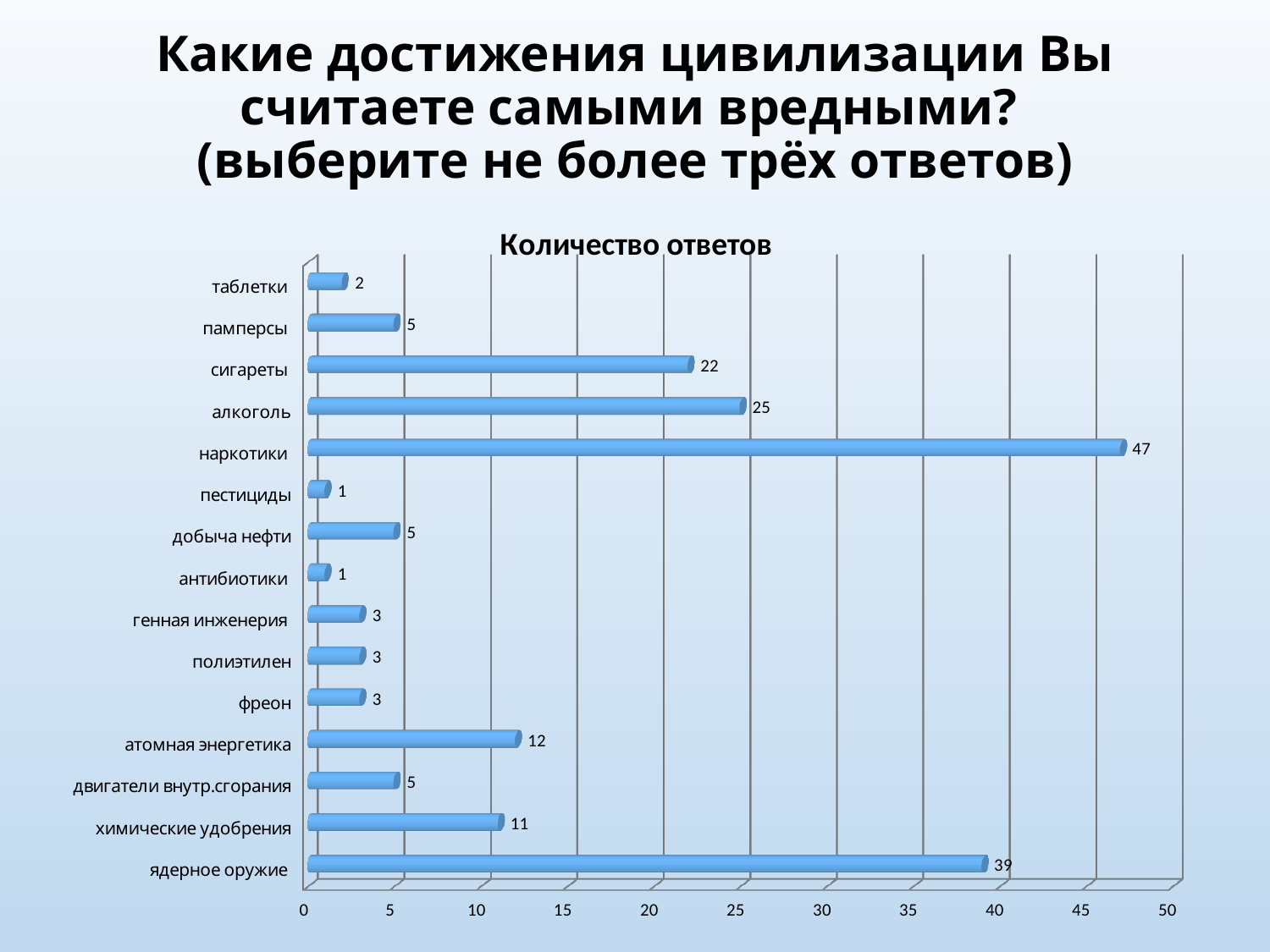
What is the difference between the values for алкоголь and сигареты? 3 Is the value for ядерное оружие greater or less than 35? greater What is the value for атомная энергетика? 12 What is the title of the chart? Количество ответов What is the difference between the values for наркотики and ядерное оружие? 8 What kind of chart is shown on the slide? bar chart What is the value for наркотики? 47 What is the value for ядерное оружие? 39 Which is larger, the value for химические удобрения or the value for атомная энергетика? атомная энергетика Which category has the highest value? наркотики What is the value for сигареты? 22 How many categories are shown in the chart? 15